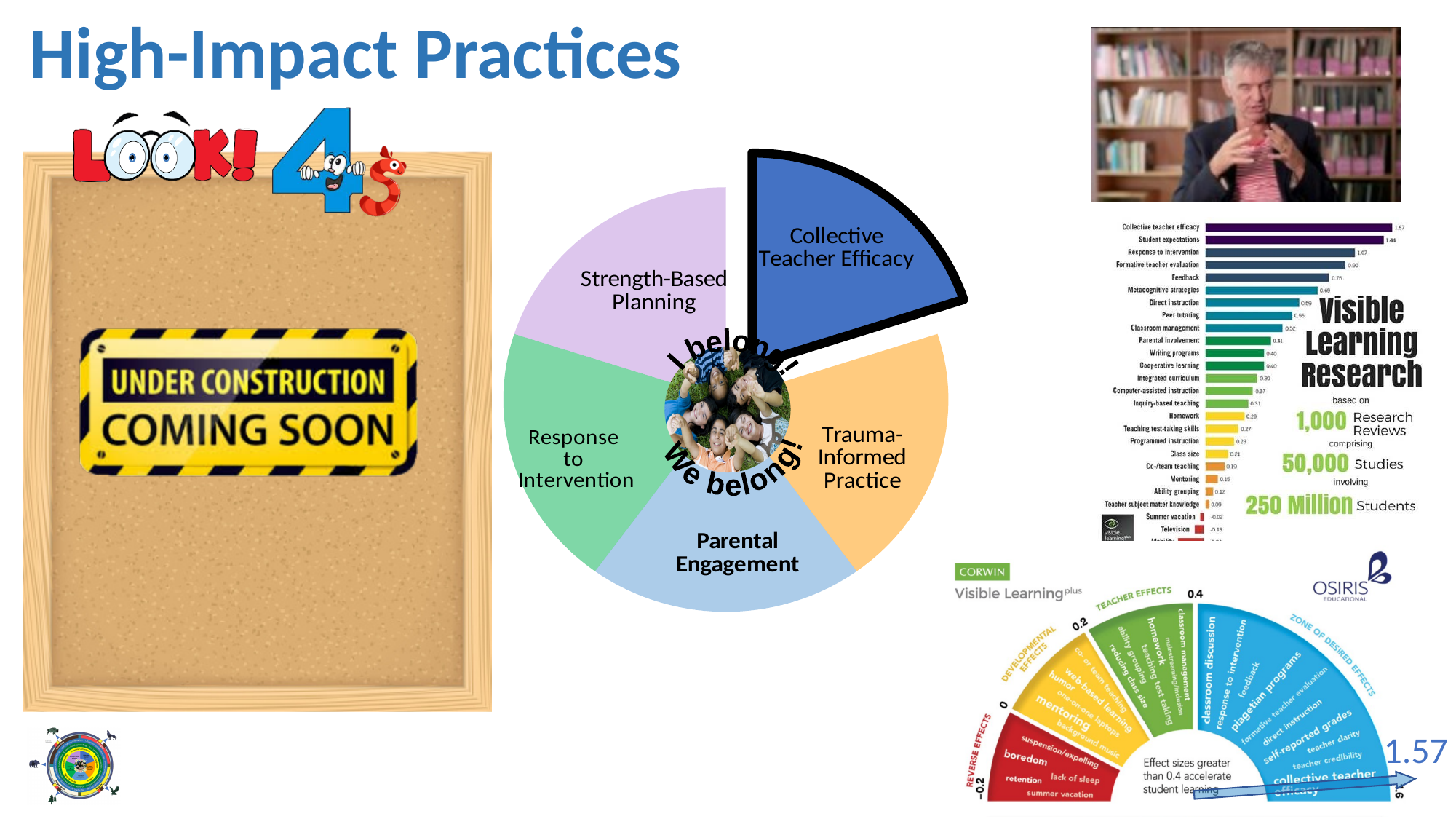
In the pie chart in the centre of the slide, which slice is pulled out from the rest and outlined in black? Collective Teacher Efficacy What kind of chart is the chart in the centre of the slide with the slices labelled Collective Teacher Efficacy and Parental Engagement? Pie chart In the Visible Learning Research bar chart on the right of the slide, which is larger, Feedback or Homework? Feedback In the Visible Learning Research bar chart on the right of the slide, what is the value for Response to intervention? 1.07 How many slices does the pie chart in the centre of the slide have? 5 In the pie chart in the centre of the slide, what colour is the Collective Teacher Efficacy slice? Dark blue In the Visible Learning Research bar chart on the right of the slide, what is the value for Student expectations? 1.44 In the Visible Learning Research bar chart on the right of the slide, which category has the highest value? Collective teacher efficacy What kind of chart is the Visible Learning Research chart on the right of the slide? Bar chart In the pie chart in the centre of the slide, which slice sits between Strength-Based Planning and Parental Engagement going counter-clockwise? Response to Intervention In the Visible Learning Research bar chart on the right of the slide, what is the value for Collective teacher efficacy? 1.57 In the Visible Learning Research bar chart on the right of the slide, what is the difference between Collective teacher efficacy and Student expectations? 0.13